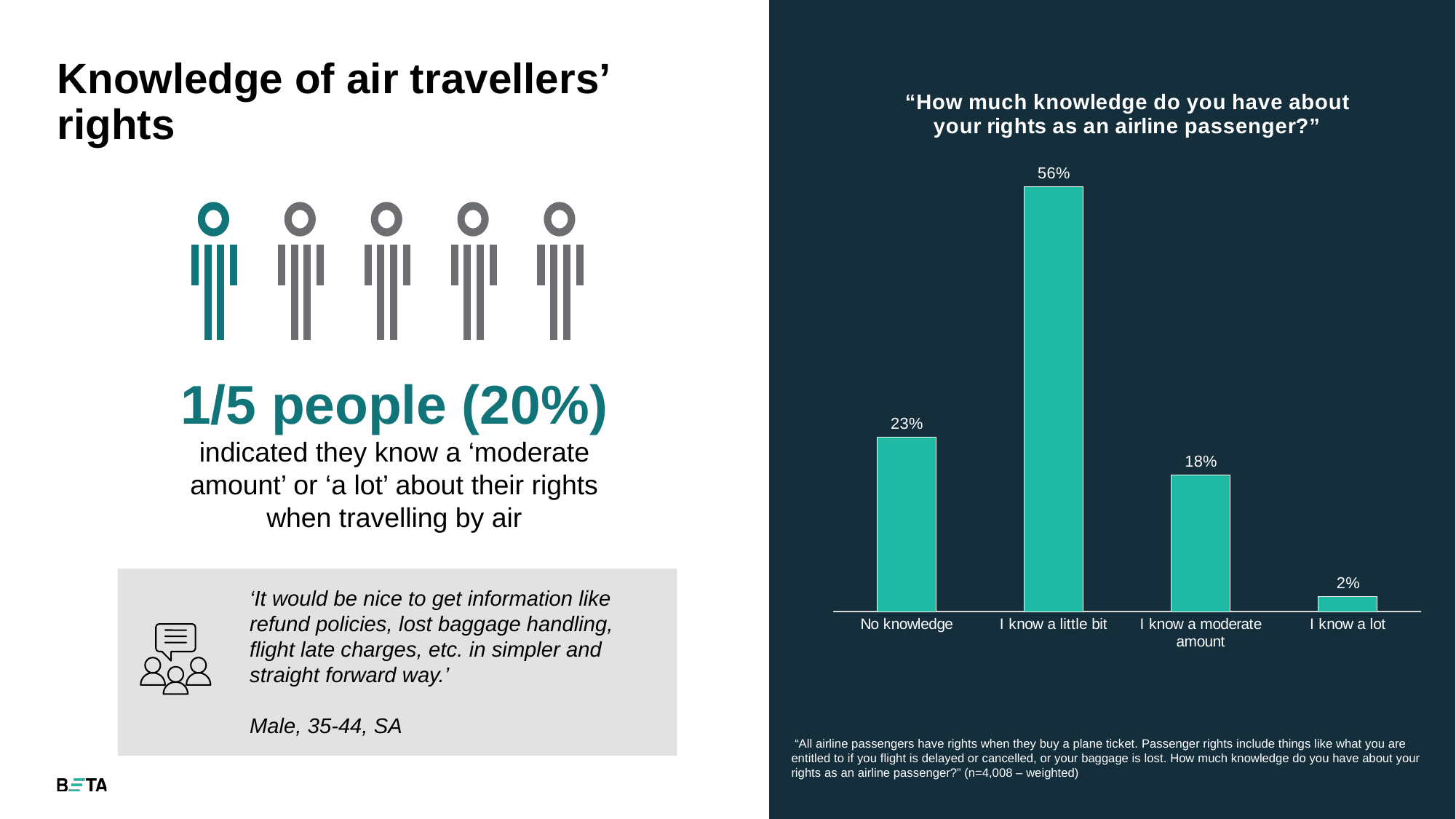
Which response category has the lowest percentage? I know a lot What percentage of respondents said 'I know a moderate amount'? 18% What percentage of respondents said 'I know a lot'? 2% What type of chart is used to show the knowledge of airline passenger rights? Bar chart What percentage of respondents said they have no knowledge of their rights as an airline passenger? 23% What is the title of the chart on the right side of the slide? "How much knowledge do you have about your rights as an airline passenger?" What is the difference in percentage points between 'No knowledge' and 'I know a moderate amount'? 5 How many response categories are shown in the bar chart? 4 What is the difference in percentage points between 'I know a little bit' and 'No knowledge'? 33 What percentage of respondents said 'I know a little bit'? 56% Which is larger: the percentage for 'No knowledge' or for 'I know a moderate amount'? No knowledge Which response category has the highest percentage? I know a little bit